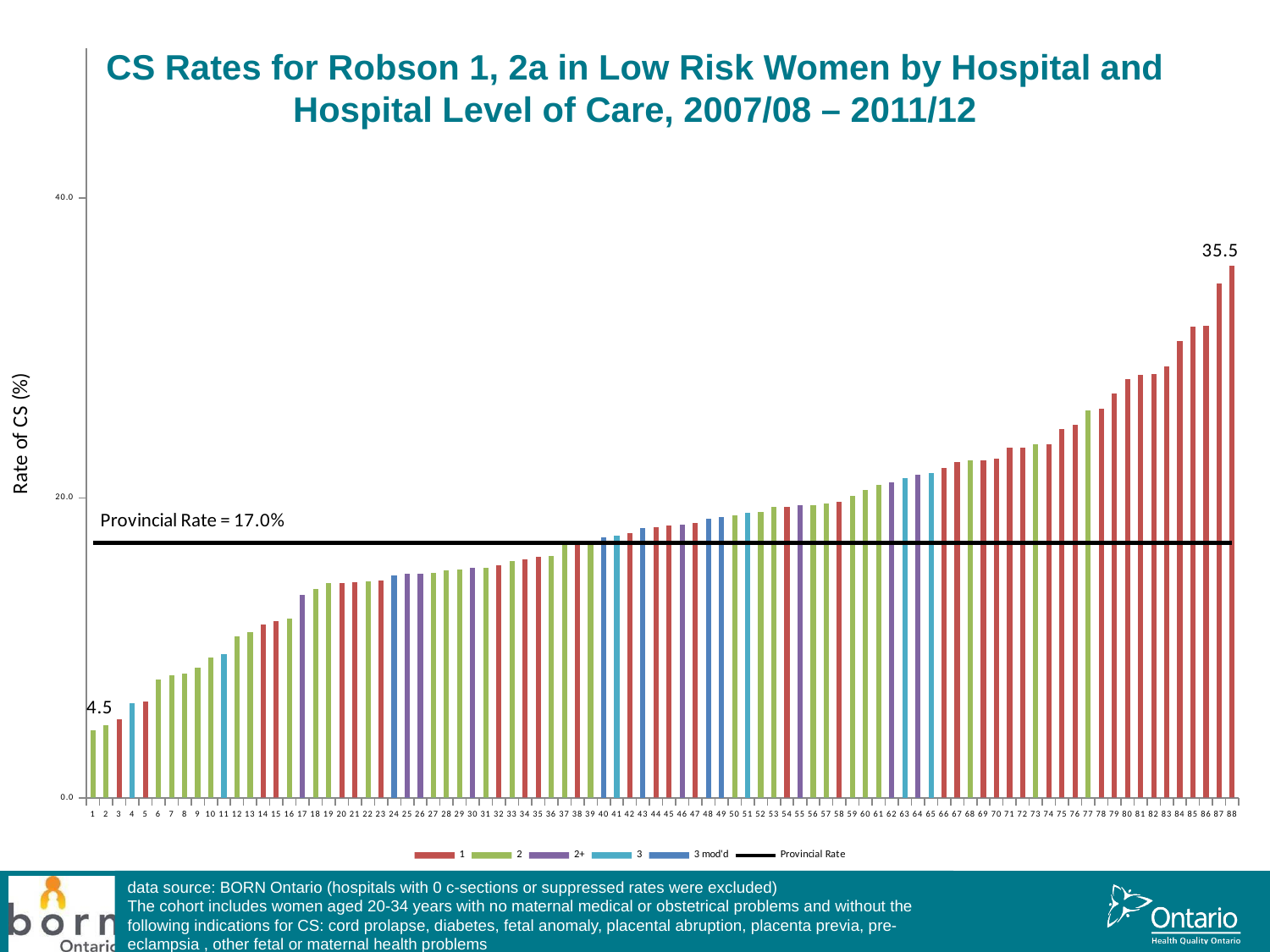
Which hospital number has the lowest CS rate? 1 Do the CS rates rise or fall from hospital 1 to hospital 88 along the x axis? rise What is the CS rate for hospital 1, the lowest bar? 4.5 Which hospital number has the highest CS rate? 88 What is the difference between the highest CS rate (35.5) and the lowest CS rate (4.5)? 31.0 Is the CS rate for hospital 30 greater or less than 20.0? less How many entries does the legend list? 6 What kind of chart is shown on the slide? bar chart Is the CS rate for hospital 70 greater or less than 20.0? greater How many hospitals are plotted on the x axis? 88 What is the CS rate for hospital 88, the highest bar? 35.5 What is the provincial rate shown by the horizontal line on the chart? 17.0%